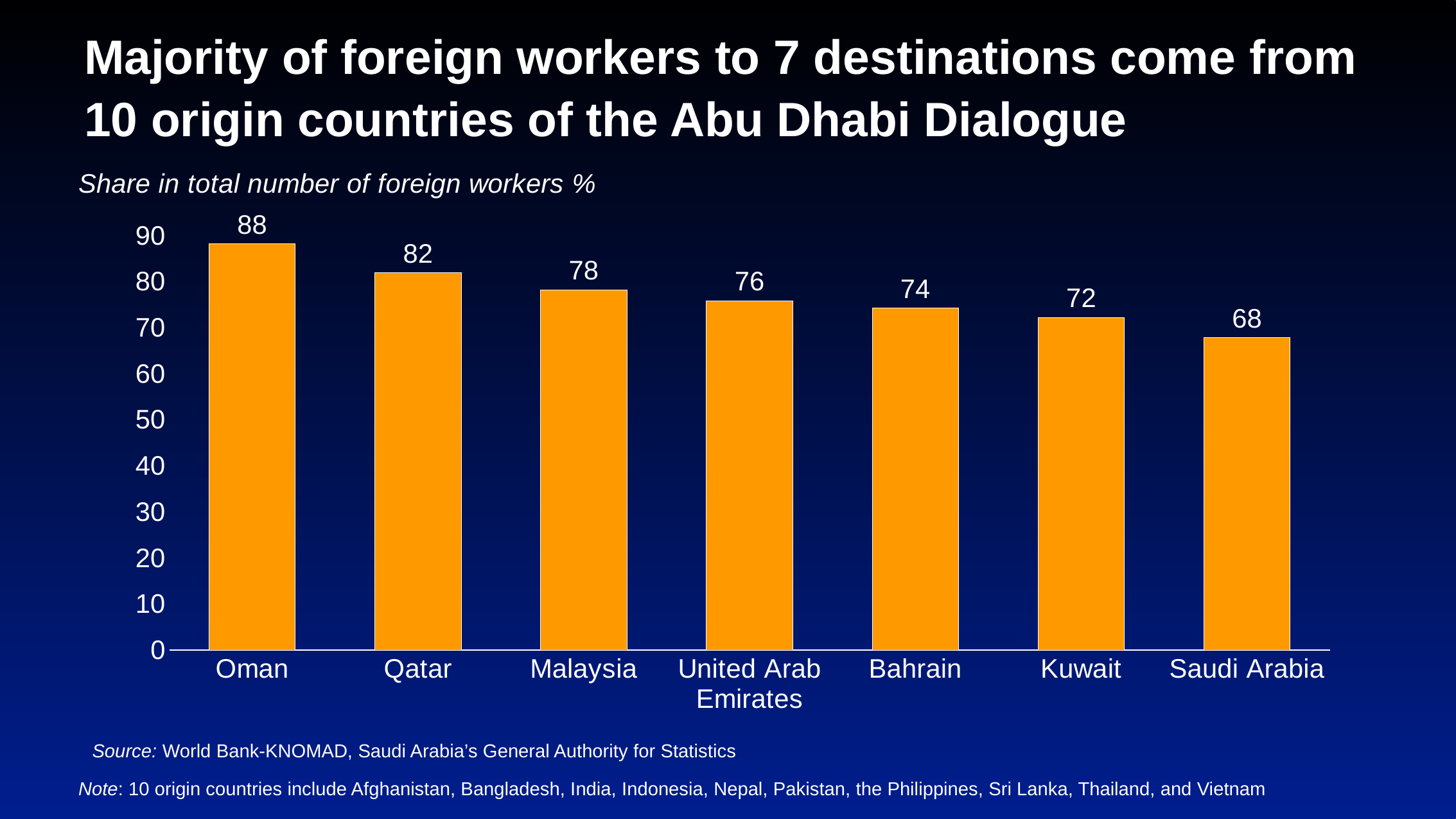
Which destination has the highest share? Oman How many destination countries are shown in the chart? 7 What is the value shown for Kuwait? 72 Which destination has the lowest share? Saudi Arabia Which has a larger value, Bahrain or Kuwait? Bahrain What is the difference between the values for Qatar and Malaysia? 4 What is the share of foreign workers from the 10 origin countries for Oman? 88 What is the value shown for United Arab Emirates? 76 Is the value for Saudi Arabia greater or less than 70? less Do the values rise or fall from left to right across the destinations? fall What is the difference between the values for Oman and Saudi Arabia? 20 What kind of chart is shown on the slide? bar chart